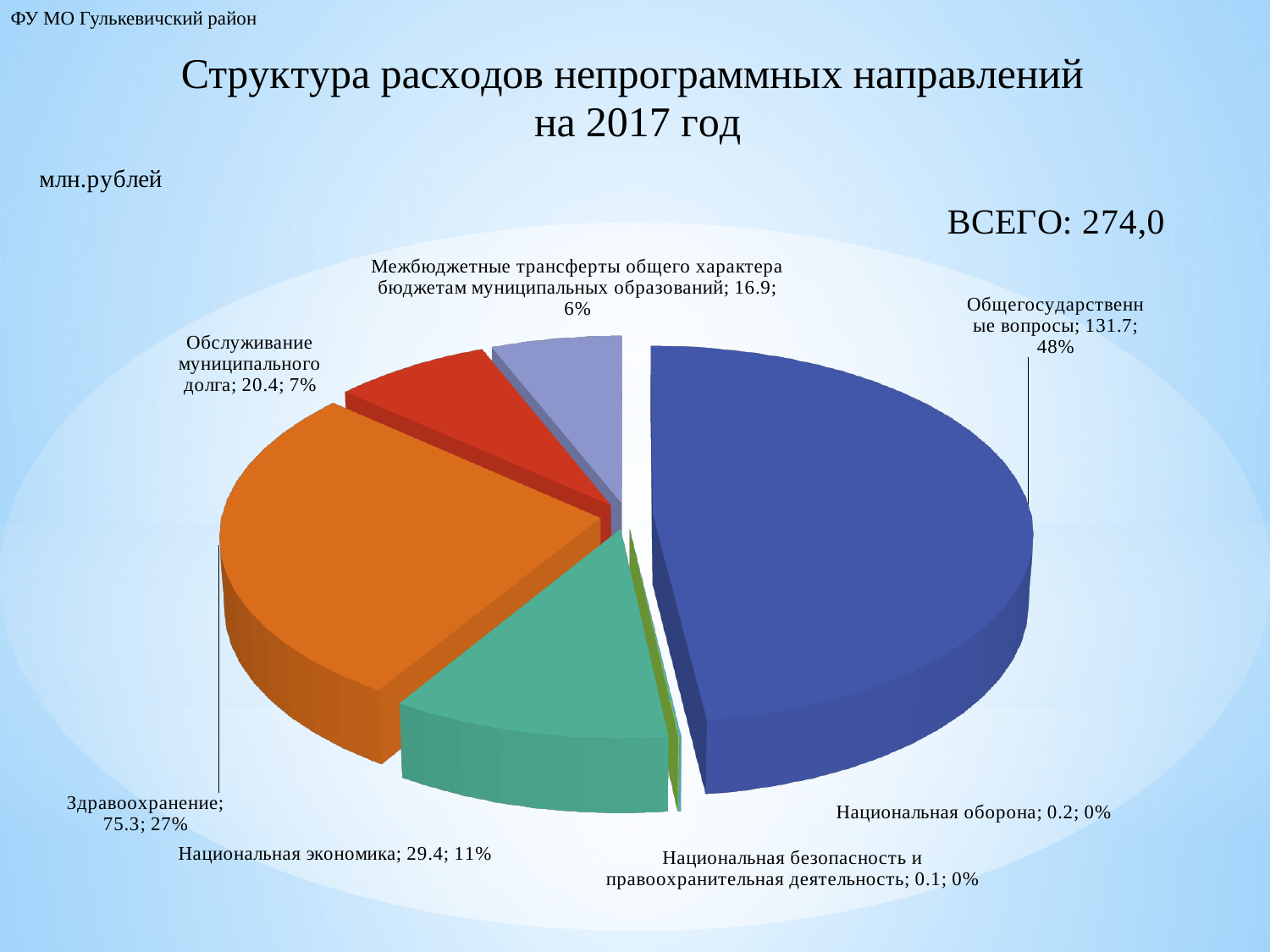
What is the value for Общегосударственные вопросы? 131.7 What share of the pie does Здравоохранение take? 27% What is the value for Здравоохранение? 75.3 What type of chart is shown on the slide? pie chart Which category has the largest value? Общегосударственные вопросы What is the difference between the values for Общегосударственные вопросы and Здравоохранение? 56.4 Which category has the smallest value? Национальная безопасность и правоохранительная деятельность What share of the pie does Межбюджетные трансферты общего характера бюджетам муниципальных образований take? 6% What is the value for Национальная экономика? 29.4 Which is larger, the value for Национальная экономика or the value for Обслуживание муниципального долга? Национальная экономика What is the value for Обслуживание муниципального долга? 20.4 How many categories does the pie chart have? 7